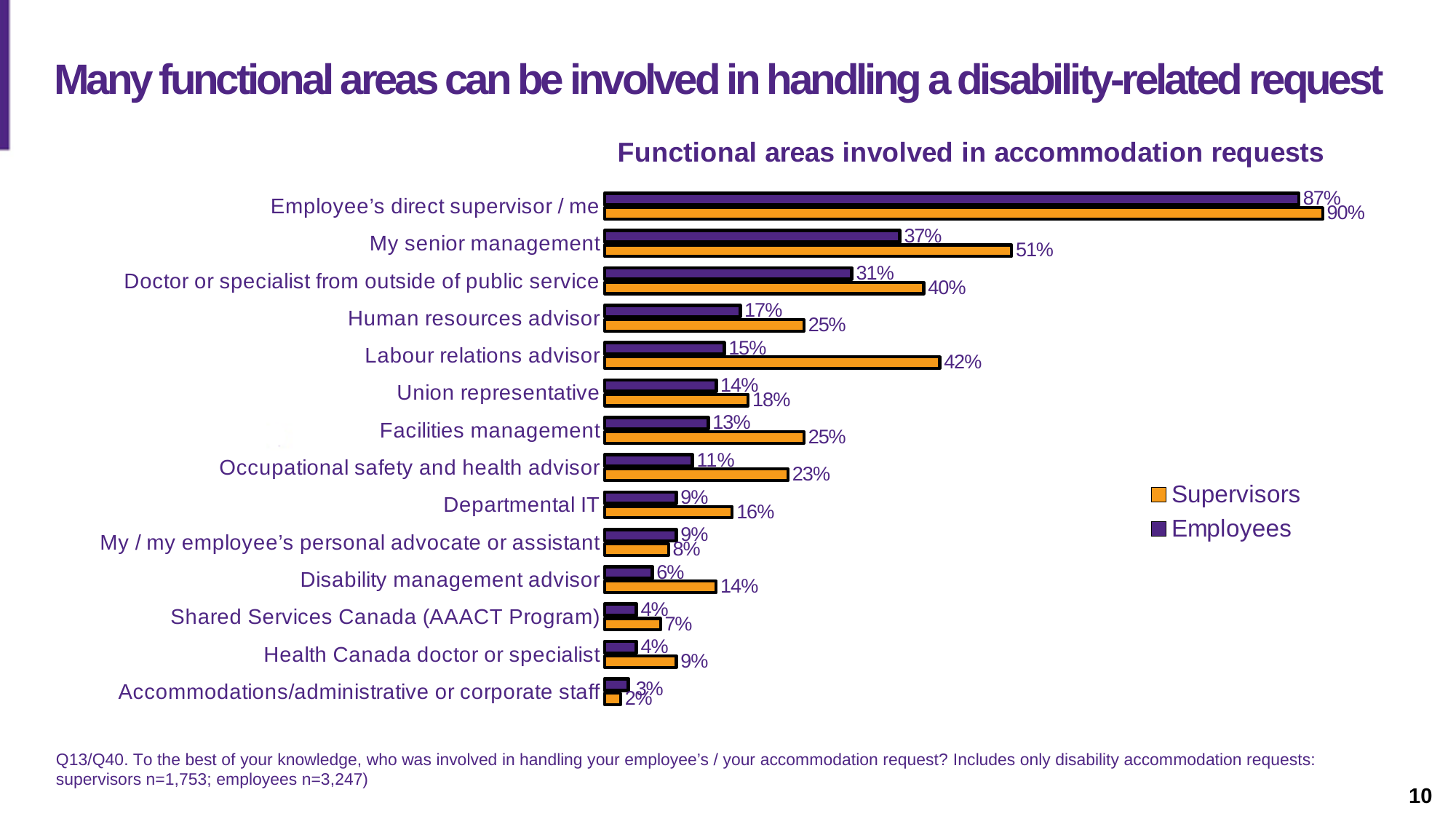
How many functional areas (categories) are shown in the chart? 14 What is the Employees value for My senior management? 37% Which functional area has the highest Employees value? Employee's direct supervisor / me What is the Supervisors value for Labour relations advisor? 42% What is the Supervisors value for Disability management advisor? 14% What is the title of the chart? Functional areas involved in accommodation requests How many series does the legend list? 2 What is the difference between the Supervisors and Employees values for Employee's direct supervisor / me? 3% Which functional area has the lowest Supervisors value? Accommodations/administrative or corporate staff What is the difference between the Supervisors and Employees values for Labour relations advisor? 27% For Human resources advisor, which series has the larger value, Supervisors or Employees? Supervisors What kind of chart is shown on the slide? Bar chart